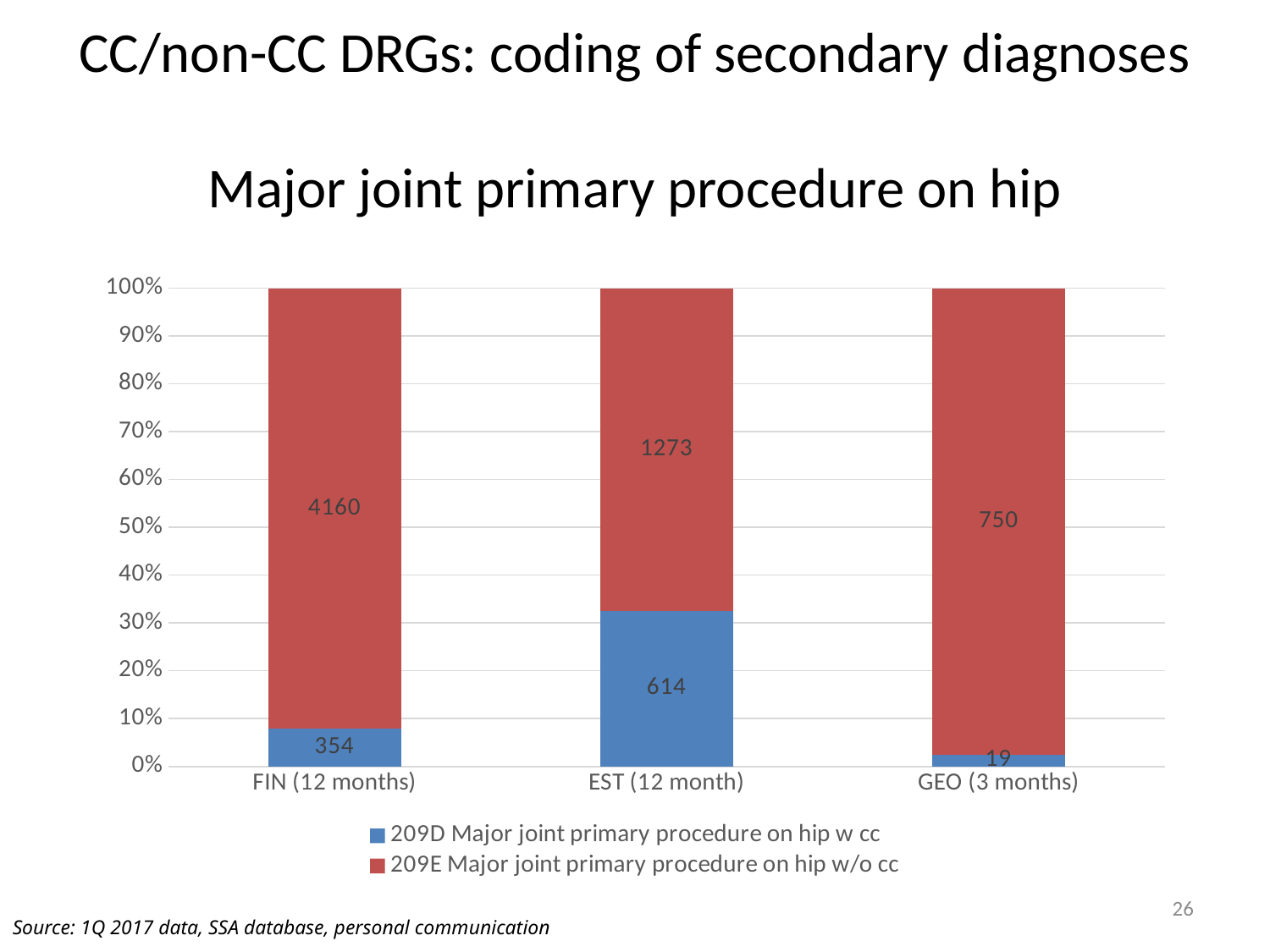
Is the share of the FIN (12 months) bar taken by 209D Major joint primary procedure on hip w cc greater or less than 10%? less Is the share of the EST (12 month) bar taken by 209D Major joint primary procedure on hip w cc greater or less than 30%? greater What is the difference between the 209D w cc values for EST (12 month) and FIN (12 months)? 260 What is the value for 209E Major joint primary procedure on hip w/o cc for EST (12 month)? 1273 Which is larger: the 209E w/o cc value for EST (12 month) or for GEO (3 months)? EST (12 month) What is the value for 209D Major joint primary procedure on hip w cc for FIN (12 months)? 354 What is the total of the two values in the GEO (3 months) bar? 769 Which category has the lowest value for 209D Major joint primary procedure on hip w cc? GEO (3 months) How many series does the legend list? 2 What is the value for 209D Major joint primary procedure on hip w cc for GEO (3 months)? 19 Which category has the highest value for 209E Major joint primary procedure on hip w/o cc? FIN (12 months) How many categories are shown on the x axis? 3